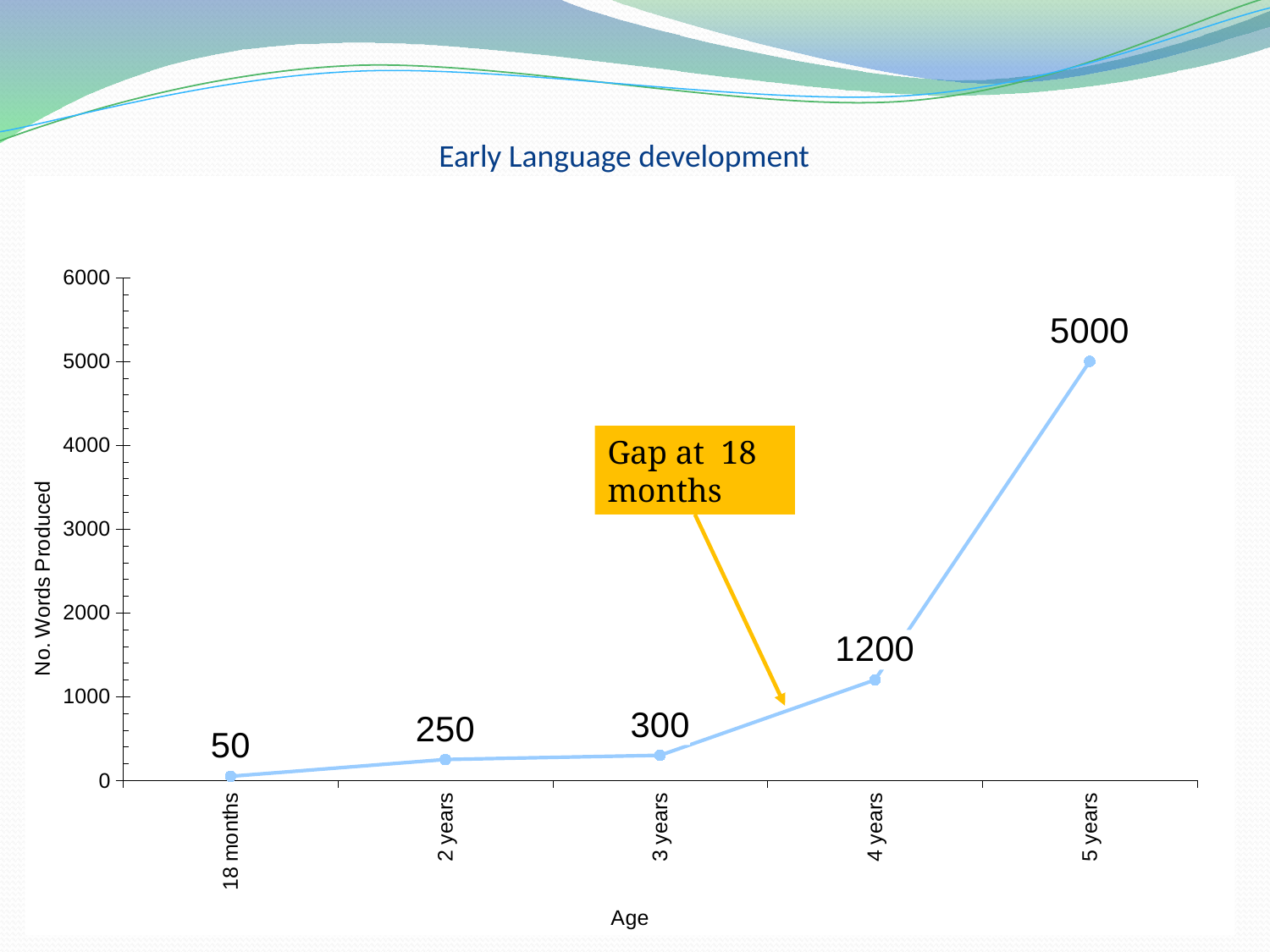
How many age points are plotted on the chart? 5 What kind of chart is shown on the slide? line chart What is the number of words produced at 18 months? 50 What is the difference in words produced between 5 years and 4 years? 3800 What is the number of words produced at 4 years? 1200 Do the values rise or fall as age increases along the x axis? rise At which age is the number of words produced lowest? 18 months What is the number of words produced at 5 years? 5000 What is the difference in words produced between 3 years and 2 years? 50 At which age is the number of words produced highest? 5 years Which has more words produced, 2 years or 4 years? 4 years Is the value for 4 years greater or less than 1000? greater